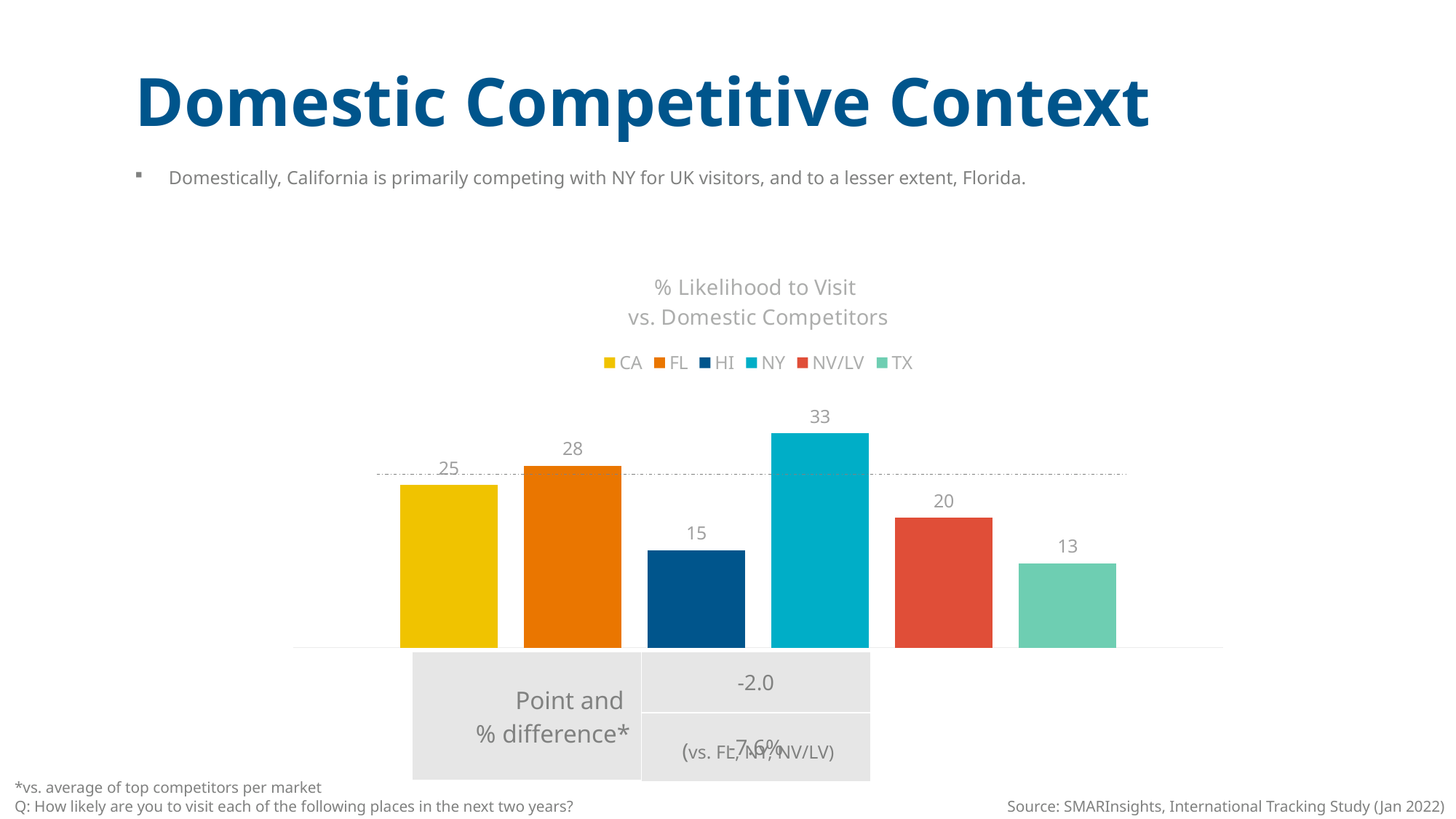
What is the % likelihood to visit value for CA? 25 How many destinations are shown in the chart? 6 What is the title of the chart? % Likelihood to Visit vs. Domestic Competitors How many series does the legend list? 6 What type of chart is shown on the slide? Bar chart What is the % likelihood to visit value for TX? 13 Which destination has the lowest % likelihood to visit? TX Which has a higher % likelihood to visit, FL or NV/LV? FL What is the % likelihood to visit value for NY? 33 What is the difference between the values for FL and HI? 13 Which destination has the highest % likelihood to visit? NY What is the difference between the values for NY and CA? 8